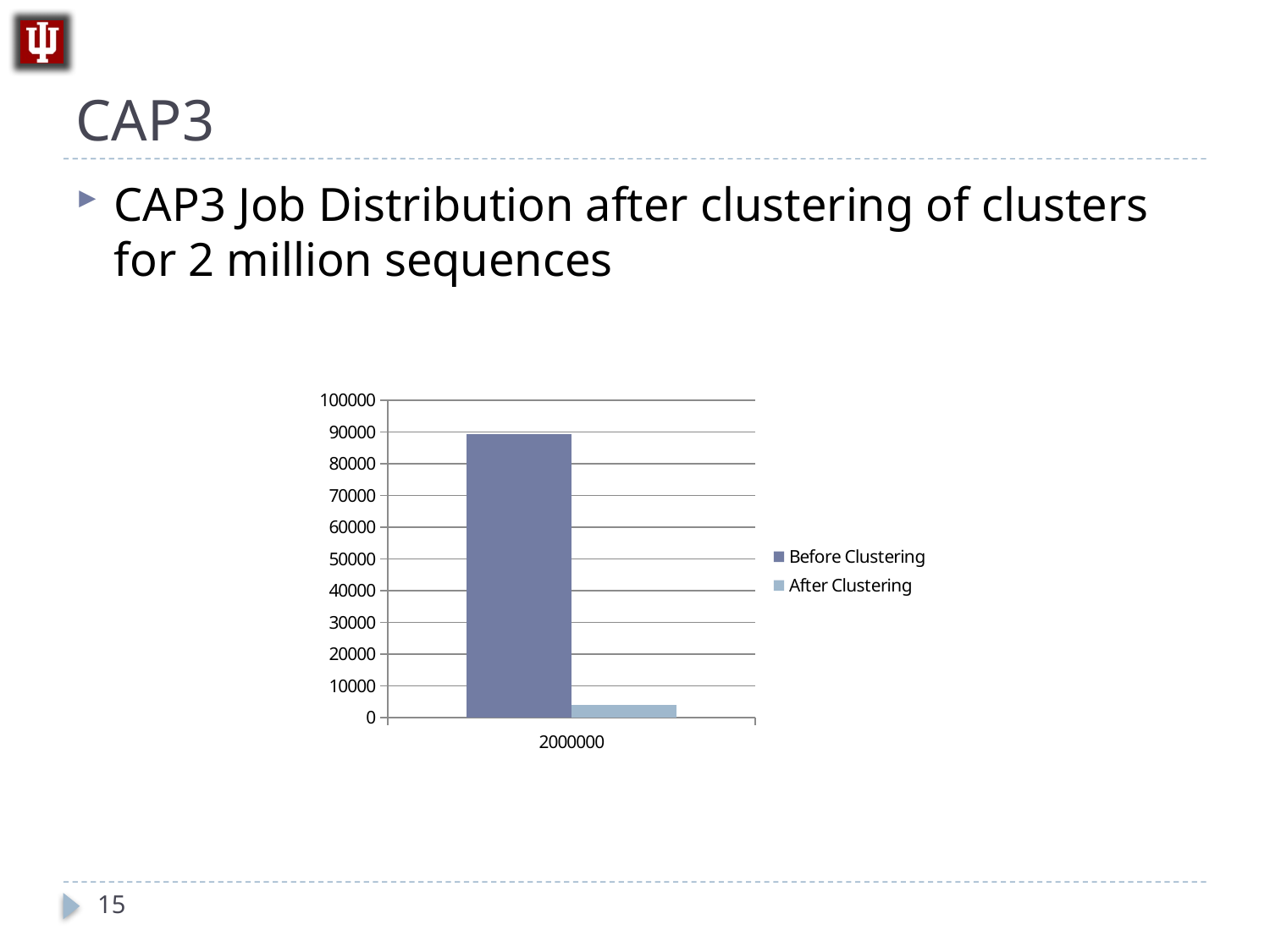
Which series has the larger value for the 2000000 category, Before Clustering or After Clustering? Before Clustering Which series has the smaller value for the 2000000 category? After Clustering How many categories are shown on the x axis of the chart? 1 What is the highest value shown on the y axis of the chart? 100000 Is the value for Before Clustering greater or less than 80000? greater What is the category label shown on the x axis of the chart? 2000000 What kind of chart is shown on the slide? bar chart Is the value for After Clustering greater or less than 10000? less Which series is shown in the darker blue colour in the chart? Before Clustering How many series does the chart legend list? 2